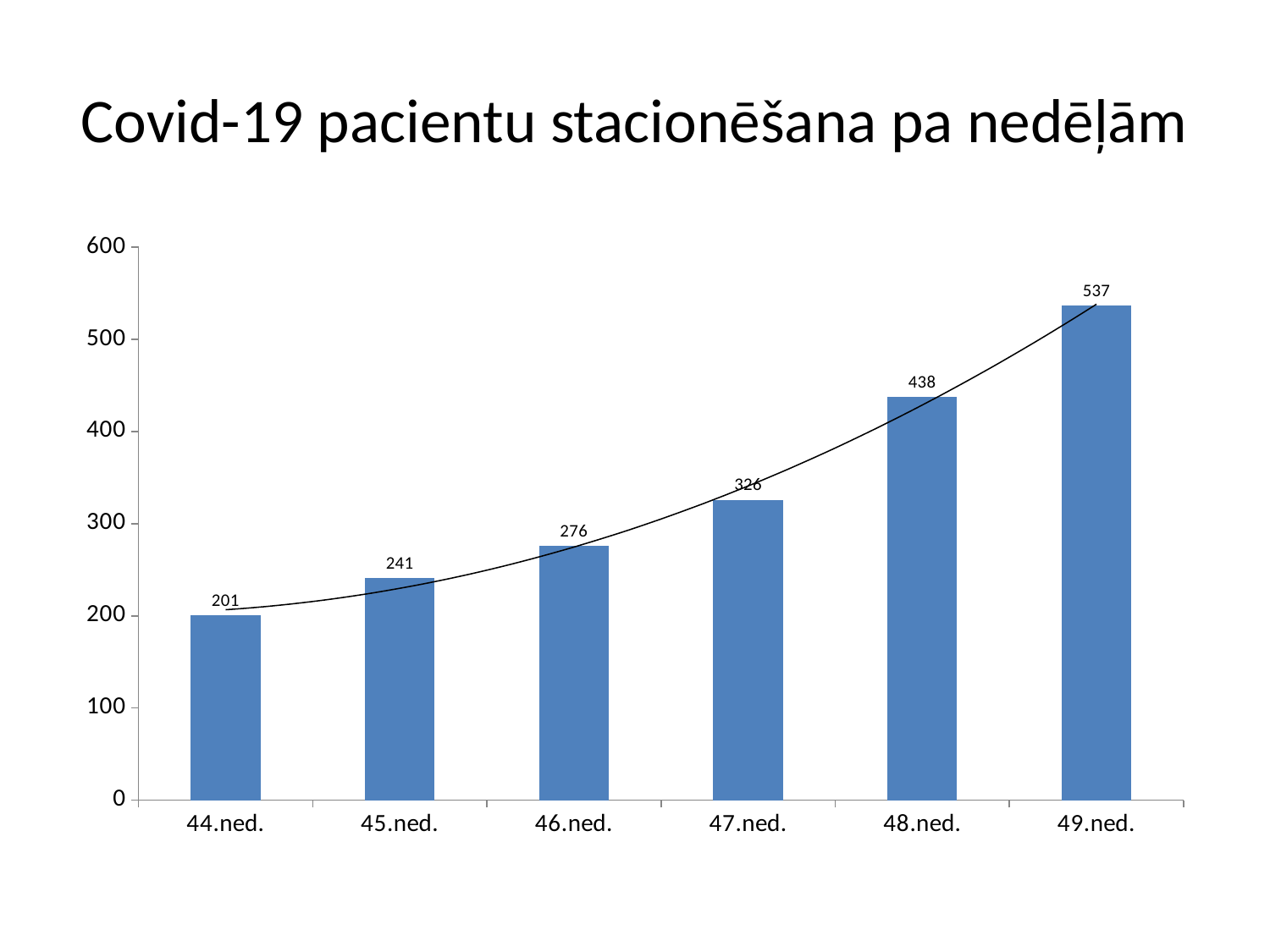
Is the value for 48.ned. greater or less than 400? greater What is the value for 49.ned.? 537 Which week has the highest value? 49.ned. Do the values rise or fall from 44.ned. to 49.ned.? rise What is the value for 44.ned.? 201 How many weeks are shown on the x axis? 6 What is the value for 47.ned.? 326 What kind of chart is this? bar chart What is the difference between the values for 49.ned. and 48.ned.? 99 Which week has the lowest value? 44.ned. What is the difference between the values for 46.ned. and 45.ned.? 35 Which is larger, the value for 48.ned. or the value for 47.ned.? 48.ned.